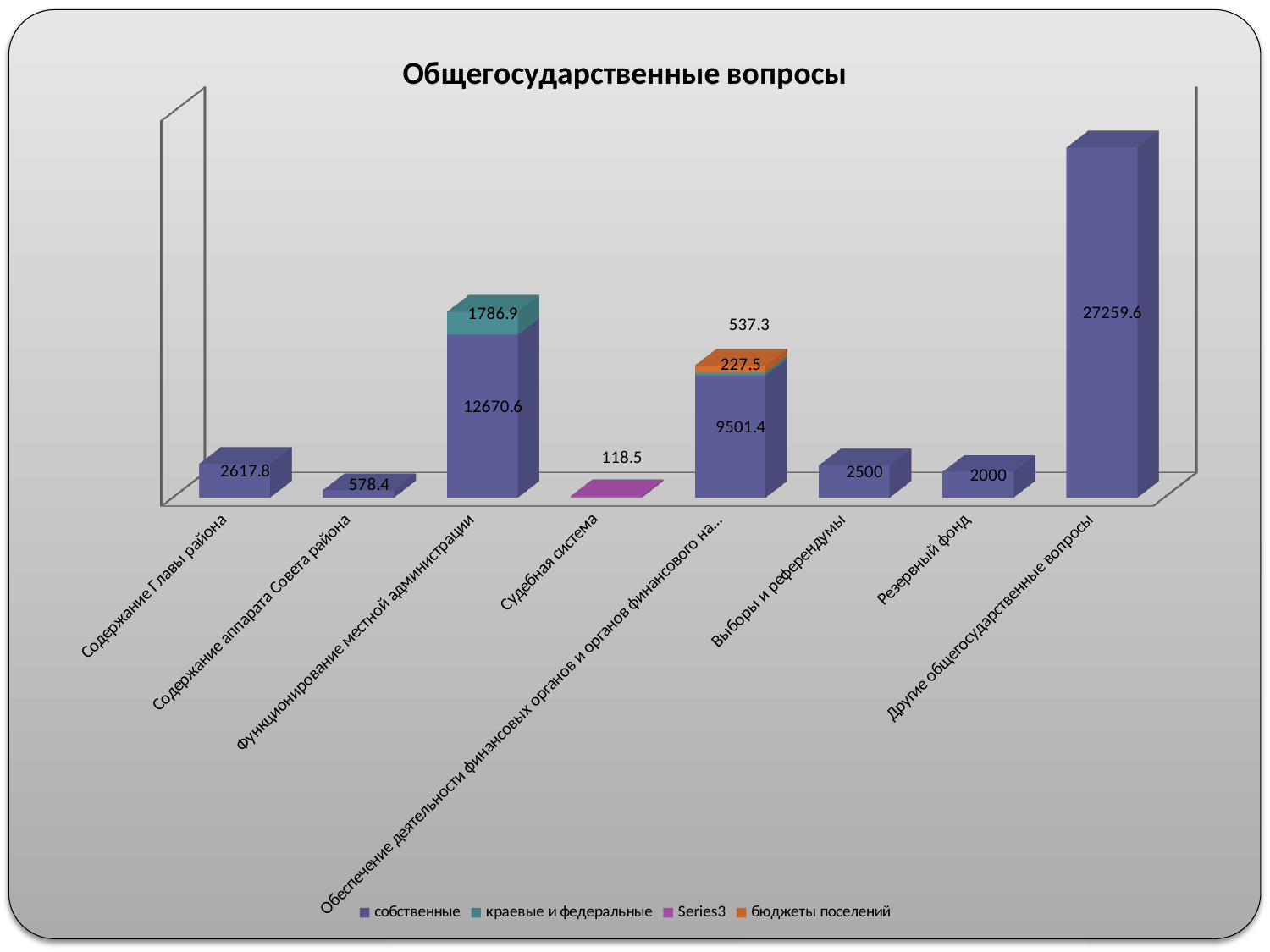
Which category has the lowest bar? Судебная система How many series does the legend list? 4 What is the title of the chart? Общегосударственные вопросы How many categories are shown on the x axis? 8 Which category has the highest bar? Другие общегосударственные вопросы What is the краевые и федеральные value for Функционирование местной администрации? 1786.9 What is the собственные value for Функционирование местной администрации? 12670.6 What is the value for Судебная система? 118.5 What is the value for Другие общегосударственные вопросы? 27259.6 What is the difference between the values for Выборы и референдумы and Резервный фонд? 500 What type of chart is shown on the slide? Bar chart What is the total of the stacked bar for Функционирование местной администрации? 14457.5